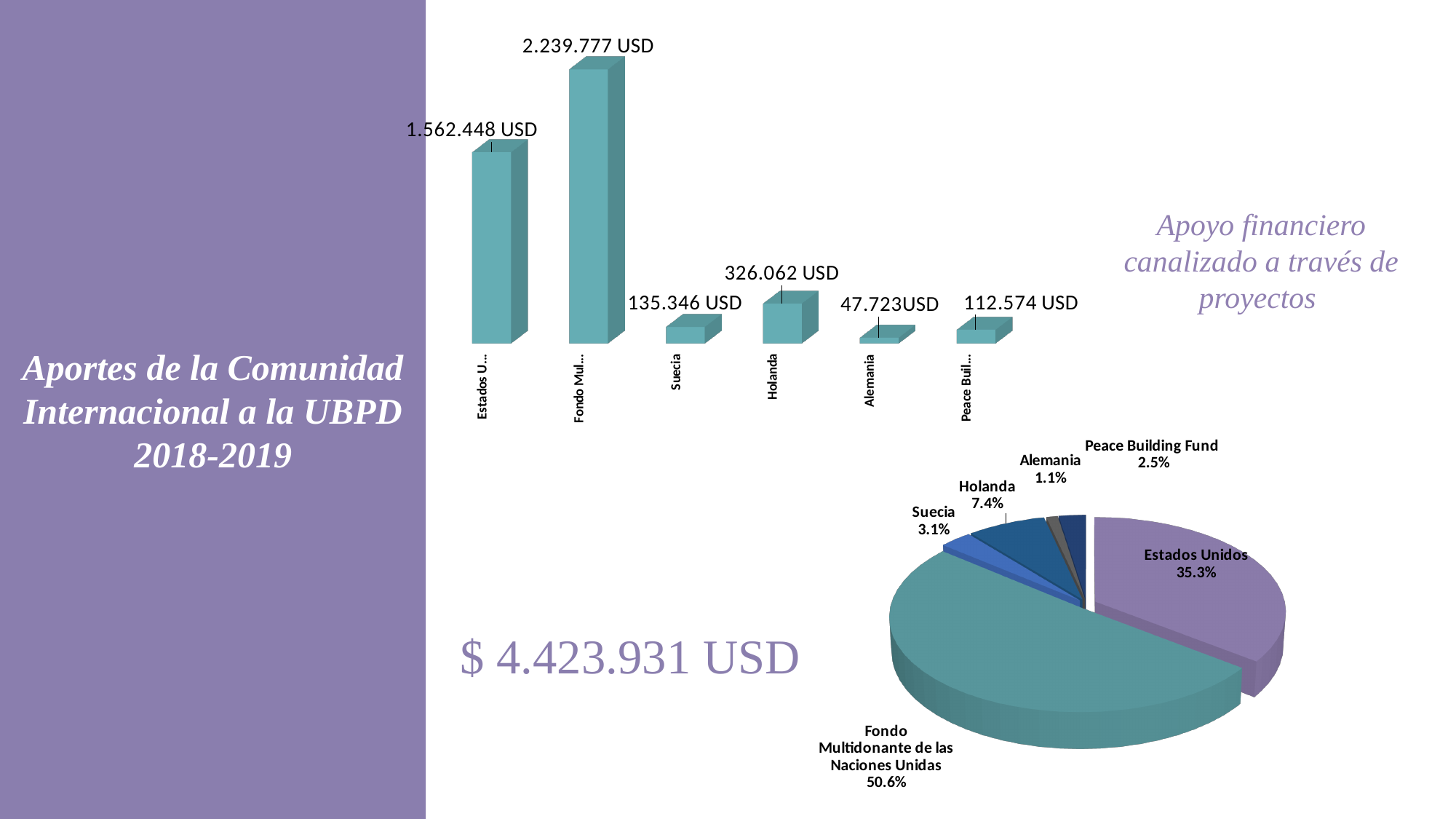
In the pie chart at the bottom right, which slice is the largest? Fondo Multidonante de las Naciones Unidas In the bar chart at the top, which category has the lowest value? Alemania In the pie chart at the bottom right, what is the difference in percentage points between Fondo Multidonante de las Naciones Unidas and Estados Unidos? 15.3 percentage points In the bar chart at the top, what is the difference between the values for Holanda and Suecia? 190.716 USD In the bar chart at the top, what is the value for Holanda? 326.062 USD In the pie chart at the bottom right, what share does Estados Unidos have? 35.3% In the bar chart at the top, what is the value for Alemania? 47.723 USD In the bar chart at the top, which category has the highest value? Fondo Mul... (Fondo Multidonante de las Naciones Unidas) In the bar chart at the top, which is larger: the value for Suecia or the value for Peace Buil...? Suecia What kind of chart is the chart at the top of the slide? Bar chart How many bars are in the bar chart at the top? 6 In the bar chart at the top, what is the value for Suecia? 135.346 USD